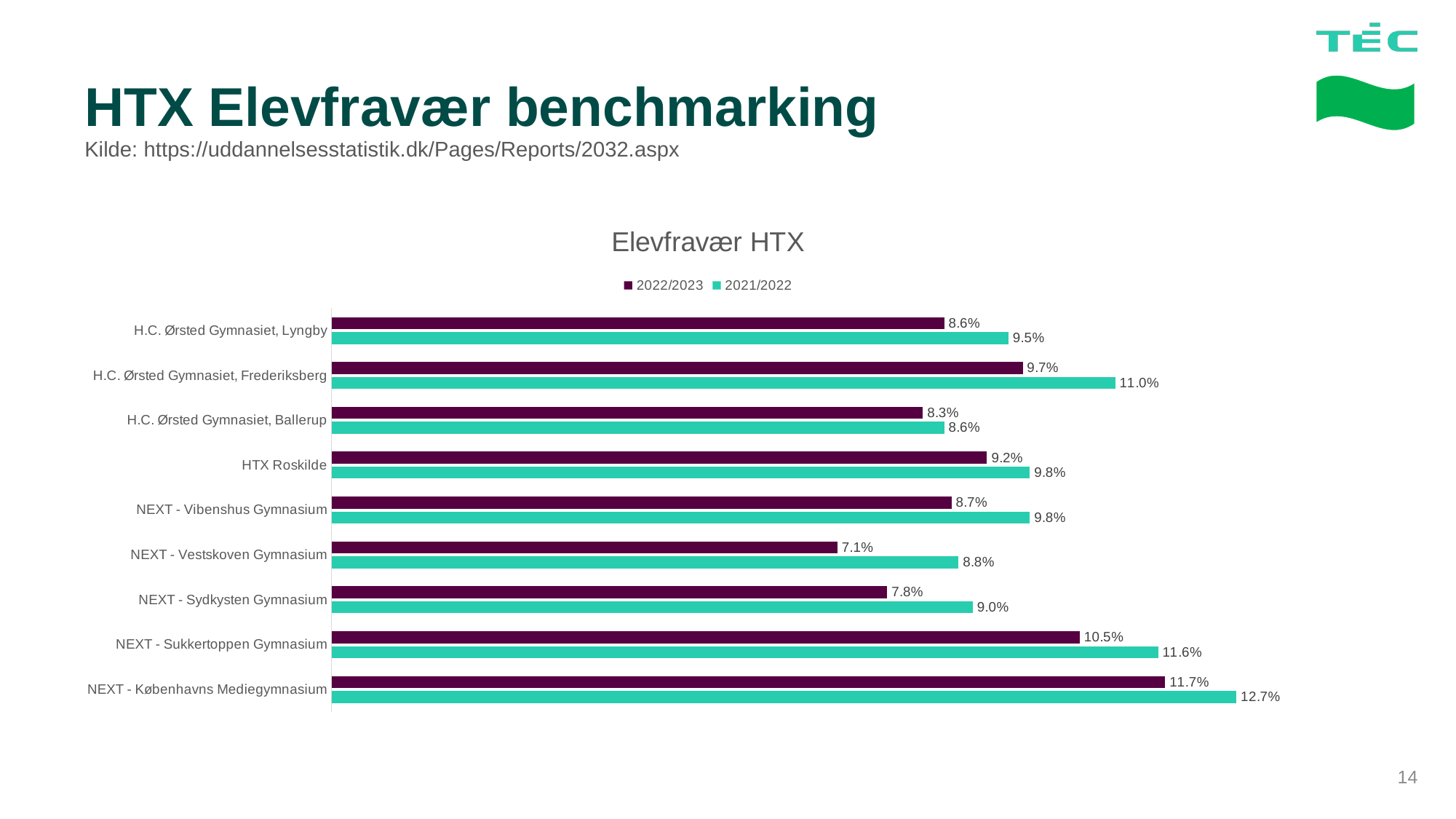
How many series does the legend list? 2 What is the 2022/2023 value for H.C. Ørsted Gymnasiet, Lyngby? 8.6% What kind of chart is shown on the slide? Bar chart Which school has the lowest 2022/2023 value? NEXT - Vestskoven Gymnasium What is the 2021/2022 value for NEXT - Sukkertoppen Gymnasium? 11.6% Which is larger for HTX Roskilde: the 2022/2023 value or the 2021/2022 value? 2021/2022 What is the 2022/2023 value for NEXT - Vestskoven Gymnasium? 7.1% What is the title of the chart? Elevfravær HTX How many schools are shown on the chart? 9 Which series is shown in dark purple? 2022/2023 What is the difference between the 2021/2022 and 2022/2023 values for H.C. Ørsted Gymnasiet, Frederiksberg? 1.3% Which school has the highest 2021/2022 value? NEXT - Københavns Mediegymnasium